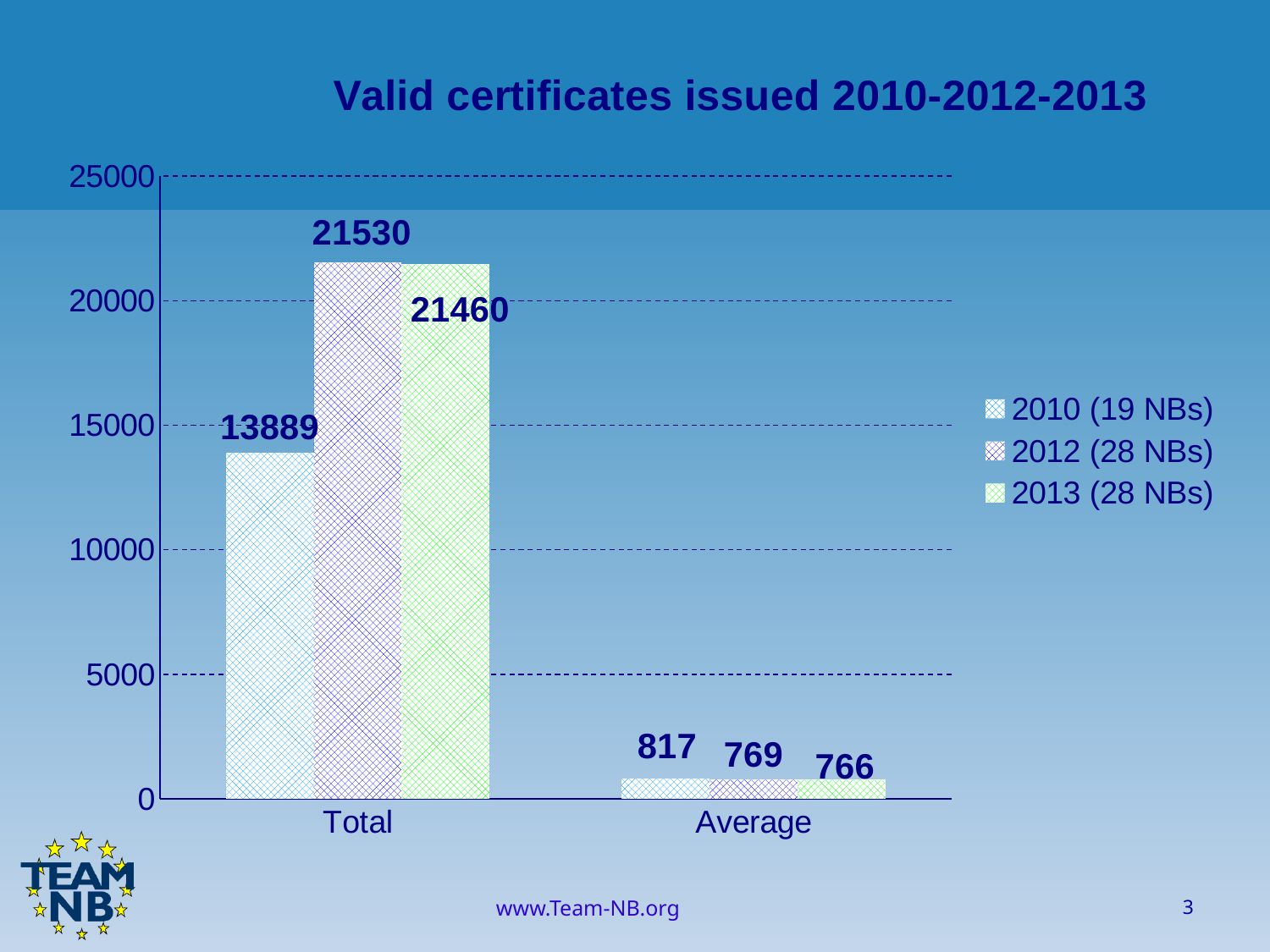
What is the Average value for 2013 (28 NBs)? 766 What is the Total value for 2012 (28 NBs)? 21530 What kind of chart is shown on the slide? Bar chart How many series does the legend list? 3 What is the difference between the Average values for 2010 (19 NBs) and 2012 (28 NBs)? 48 Which series has the highest Total value? 2012 (28 NBs) What is the title of the chart? Valid certificates issued 2010-2012-2013 What is the Average value for 2010 (19 NBs)? 817 What is the difference between the Total values for 2012 (28 NBs) and 2010 (19 NBs)? 7641 Which is larger, the Total value for 2013 (28 NBs) or the Total value for 2010 (19 NBs)? 2013 (28 NBs) What is the Total value for 2010 (19 NBs)? 13889 Which series has the lowest Average value? 2013 (28 NBs)